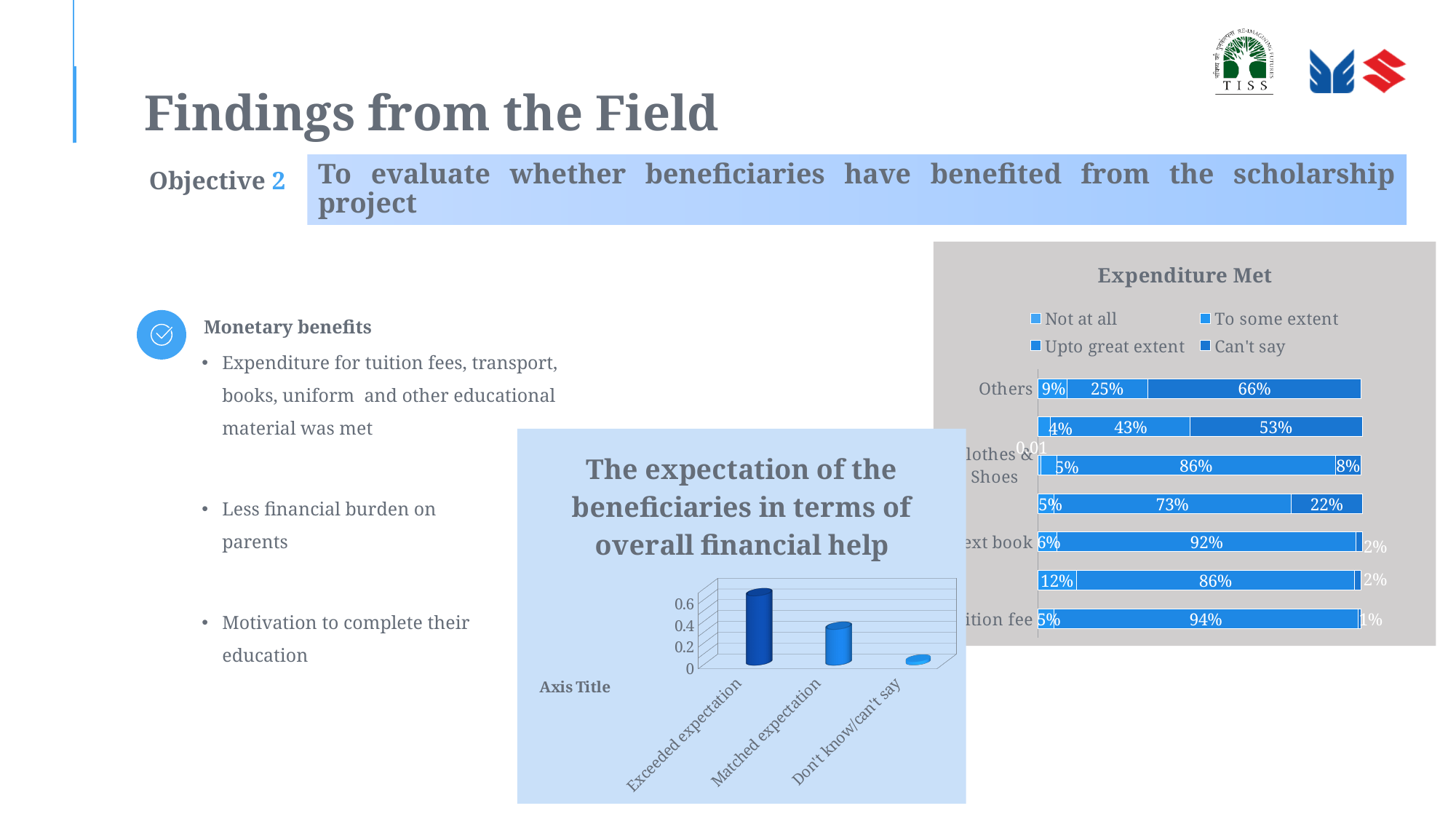
In the 'Expenditure Met' chart, what is the largest segment value shown for the 'Tuition fee' bar? 94% In the chart 'The expectation of the beneficiaries in terms of overall financial help', do the bars rise or fall from left to right along the x axis? fall In the 'Expenditure Met' chart, what is the total of the three labelled segments in the 'Others' bar? 100% In the 'Expenditure Met' chart, what is the largest segment value shown for the 'Text book' bar? 92% What kind of chart is 'The expectation of the beneficiaries in terms of overall financial help'? Bar chart In the 'Expenditure Met' chart, what is the difference between the largest segment of the 'Tuition fee' bar and the largest segment of the 'Others' bar? 28% In the 'Expenditure Met' chart, what is the smallest segment value shown for the 'Others' bar? 9% In the chart 'The expectation of the beneficiaries in terms of overall financial help', which category has the highest bar? Exceeded expectation In the 'Expenditure Met' chart, how many entries does the legend list? 4 In the 'Expenditure Met' chart, what is the largest segment value shown for the 'Others' bar? 66% In the chart 'The expectation of the beneficiaries in terms of overall financial help', how many categories are shown on the x axis? 3